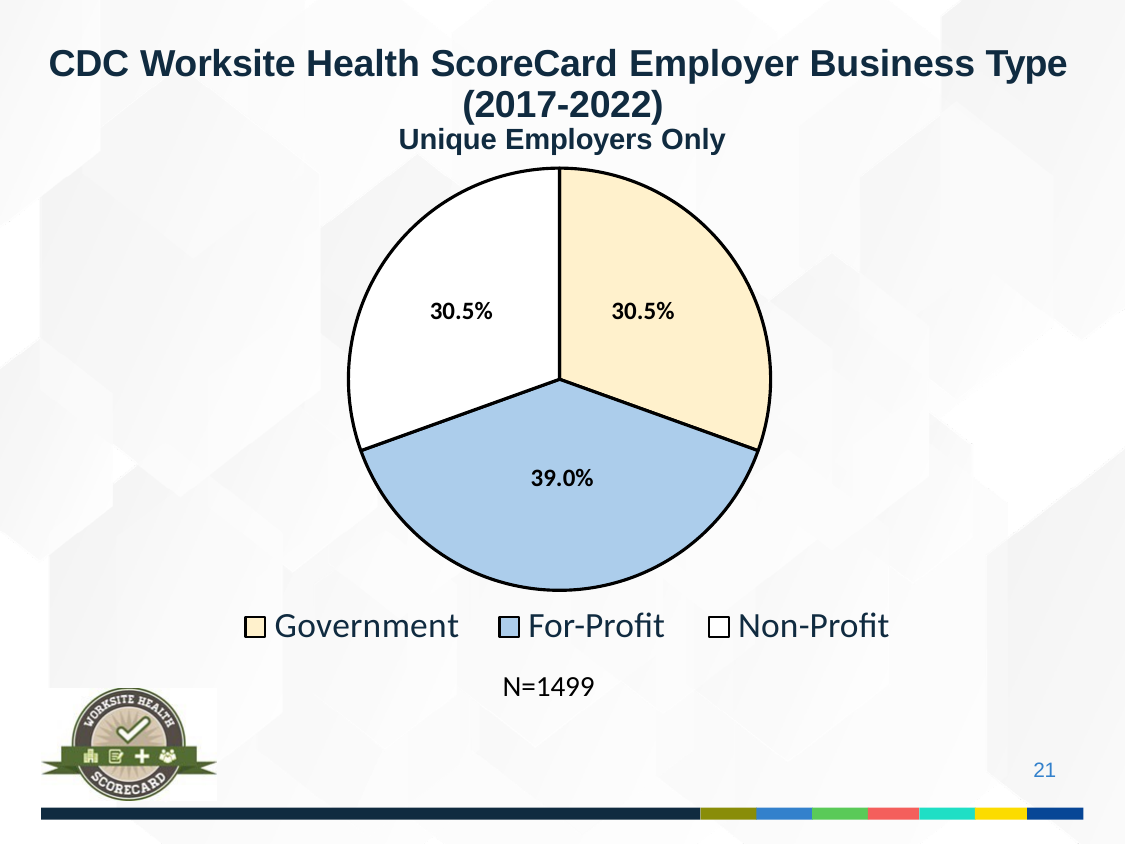
What is the sample size (N) shown below the chart? N=1499 Which legend entry is shown in blue? For-Profit How many entries does the legend list? 3 What share of the pie does For-Profit represent? 39.0% What share of the pie does Government represent? 30.5% What share of the pie does Non-Profit represent? 30.5% What kind of chart is shown on the slide? Pie chart Which business type has the largest share of the pie? For-Profit Which is larger, the For-Profit share or the Non-Profit share? For-Profit What is the difference in percentage points between the For-Profit share and the Government share? 8.5 How many slices does the pie chart have? 3